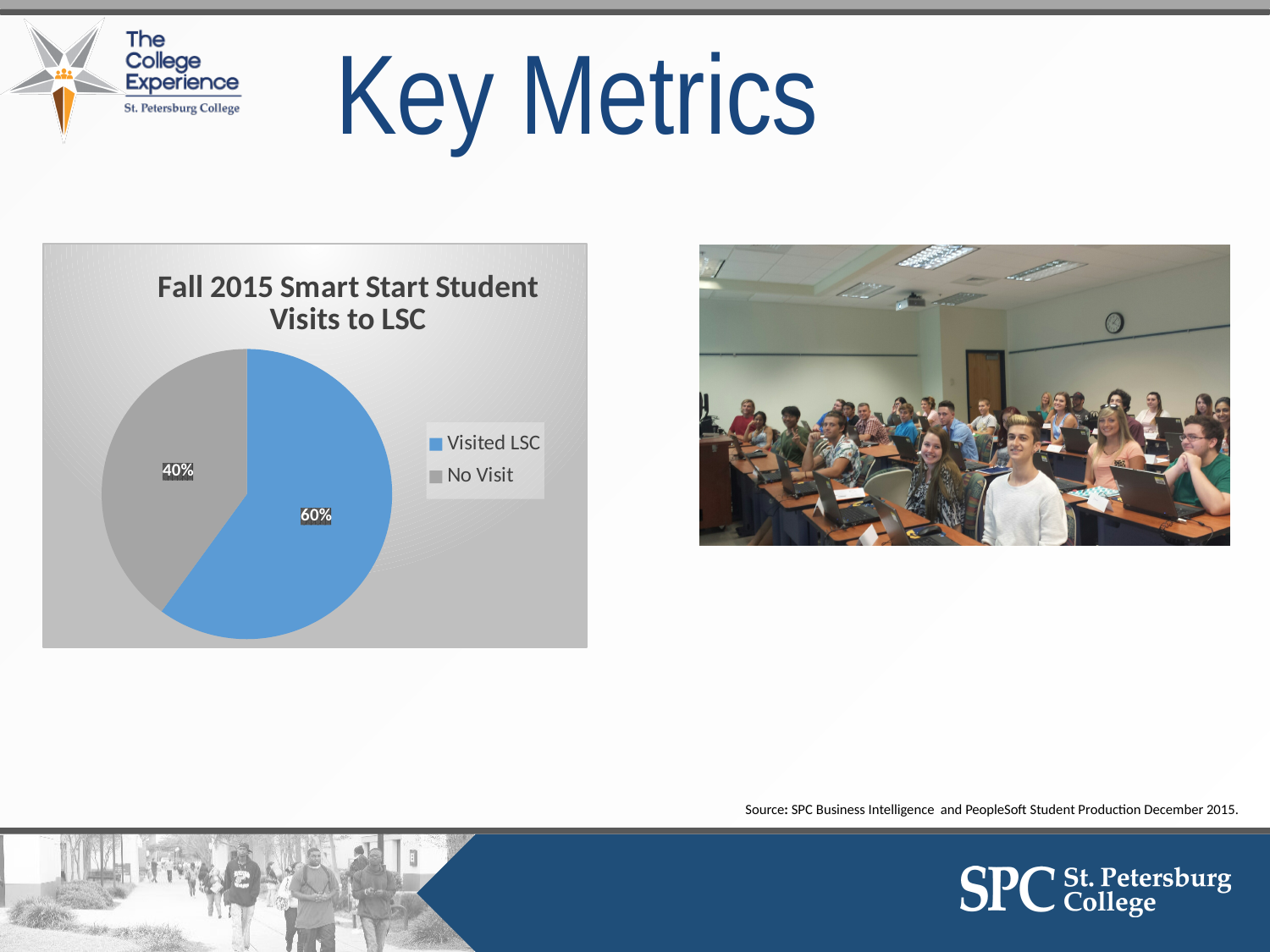
What colour is the Visited LSC slice? blue Which category has the largest share of the pie? Visited LSC How many entries does the legend list? 2 What percentage of students had no visit to the LSC? 40% Is the share for No Visit greater or less than 50%? less What is the title of the chart? Fall 2015 Smart Start Student Visits to LSC Which category has the smallest share of the pie? No Visit What kind of chart is shown on the slide? pie chart What is the difference in percentage points between Visited LSC and No Visit? 20 What percentage of students visited the LSC? 60% Which is larger, the share for Visited LSC or the share for No Visit? Visited LSC How many categories does the pie chart show? 2